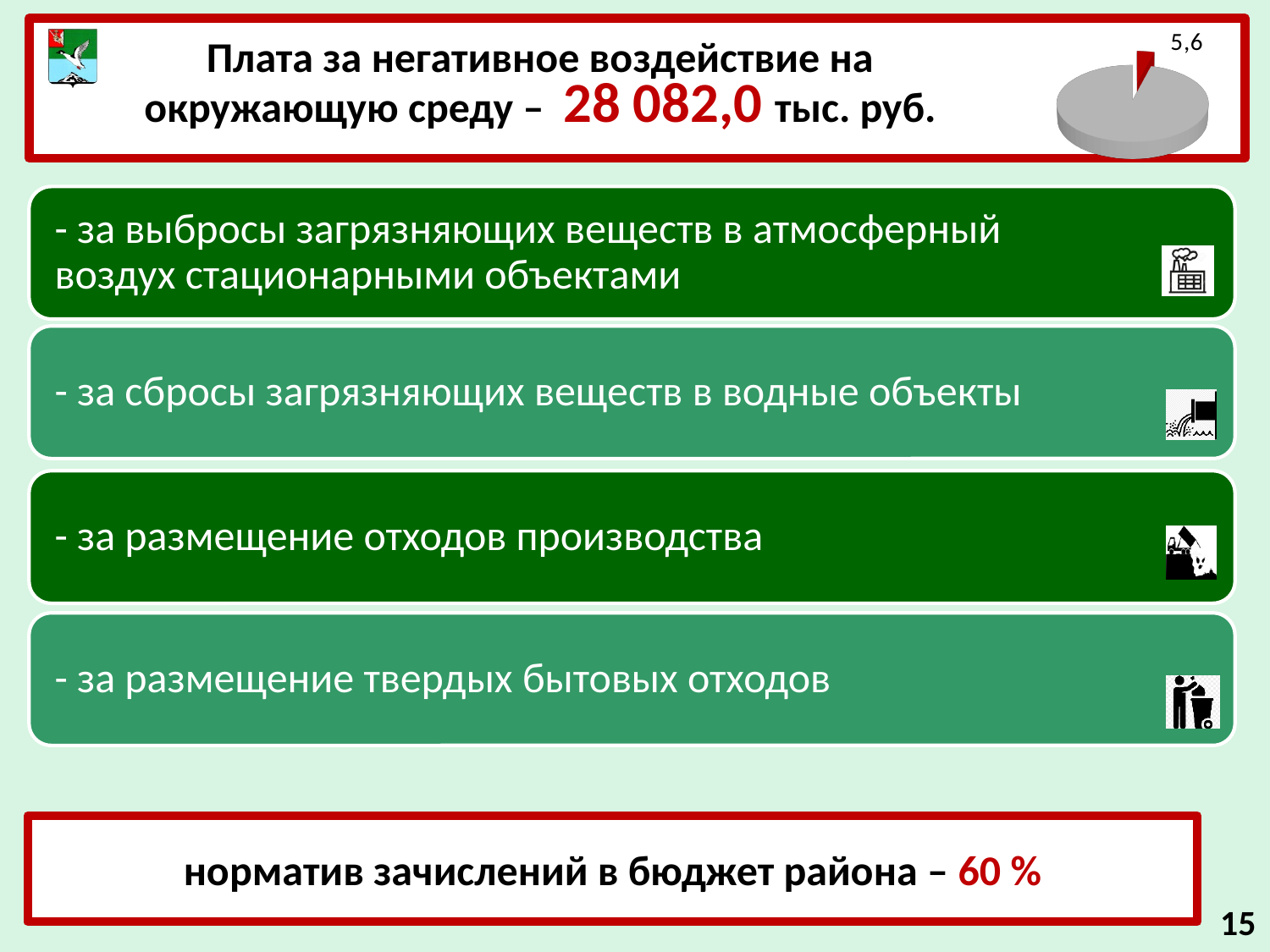
What value is printed on the small red slice of the pie chart? 5,6 What kind of chart is shown in the top right corner of the slide? pie chart Which slice of the pie chart is larger, the red one or the grey one? the grey one Which slice of the pie chart is the smallest? the red slice labelled 5,6 What colour is the slice of the pie chart that carries the label 5,6? red How many slices does the pie chart have? 2 Does the pie chart have a legend? no